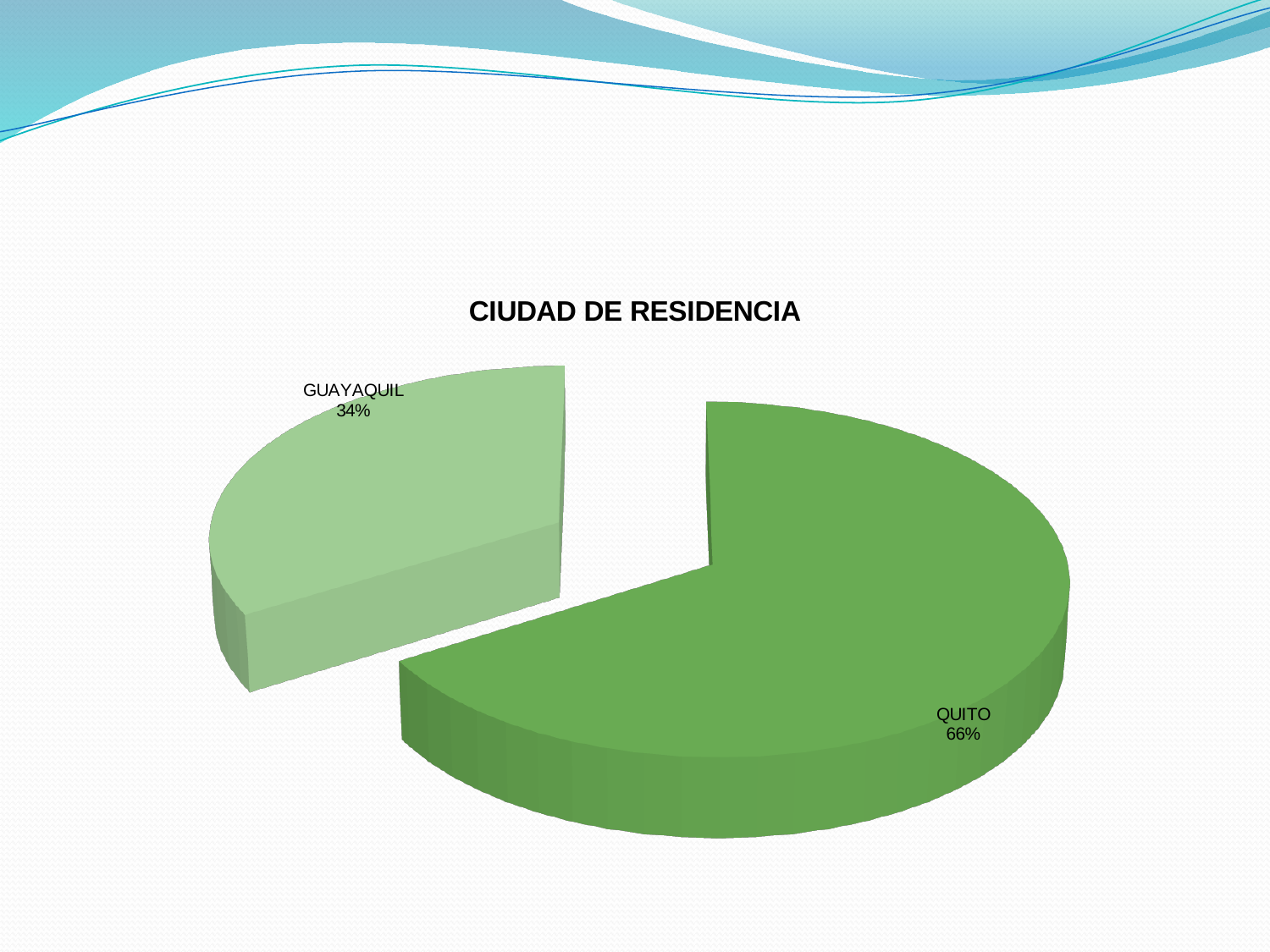
What kind of chart is shown on the slide? pie chart What is the title of the chart? CIUDAD DE RESIDENCIA Which is larger, the share for QUITO or the share for GUAYAQUIL? QUITO How many slices does the pie chart have? 2 What is the difference in percentage points between QUITO and GUAYAQUIL? 32 Which city has the smallest share of the pie? GUAYAQUIL What share of the pie does QUITO represent? 66% Which slice is shown in the lighter green colour? GUAYAQUIL What share of the pie does GUAYAQUIL represent? 34% Which city has the largest share of the pie? QUITO